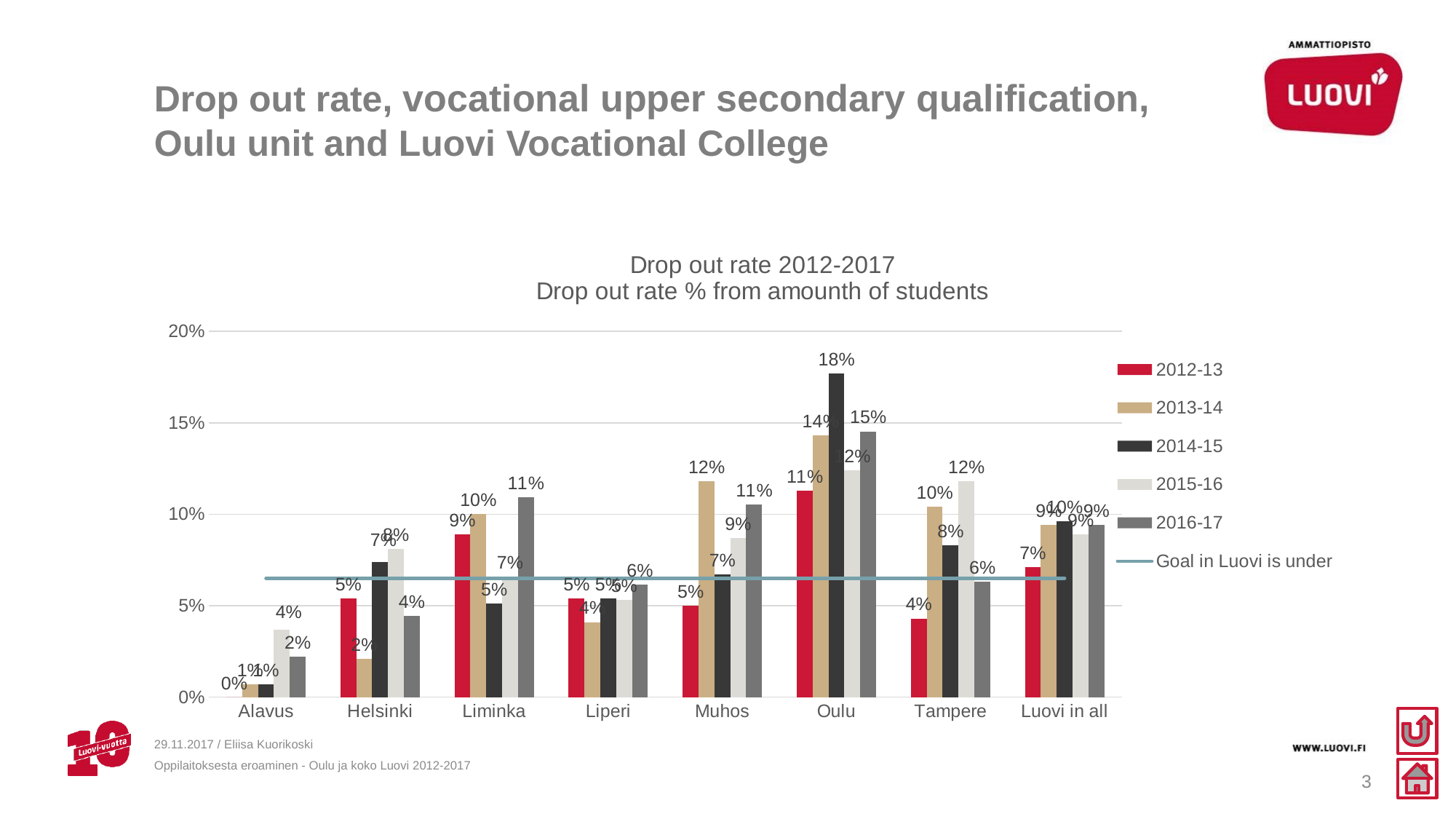
How many entries does the chart legend list? 6 What is the drop out rate for Muhos in 2013-14? 12% What kind of chart is used to show the drop out rates? Bar chart Which unit has the lowest drop out rate in 2012-13? Alavus What is the drop out rate for Luovi in all in 2012-13? 7% What is the drop out rate for Oulu in 2014-15? 18% Is the 2014-15 drop out rate for Oulu greater or less than 15%? greater Which is larger, the 2016-17 drop out rate for Liminka or for Helsinki? Liminka What colour represents the 2012-13 series? Red How many units (categories) are shown on the x axis? 8 What is the difference between Oulu's drop out rate in 2014-15 and in 2012-13? 7 percentage points Which unit has the highest drop out rate in 2014-15? Oulu